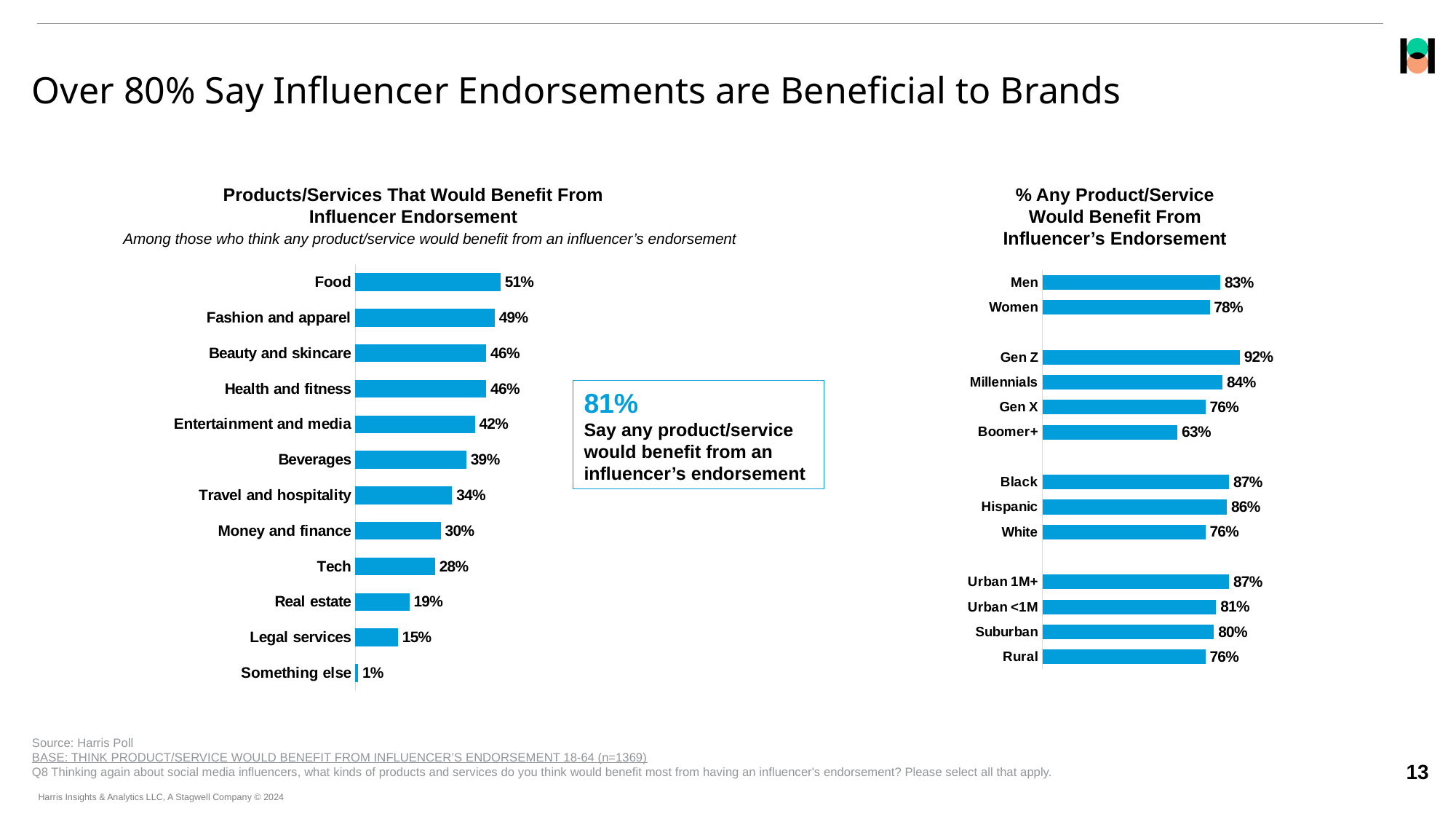
In the 'Products/Services That Would Benefit From Influencer Endorsement' chart, how many categories are shown? 12 In the '% Any Product/Service Would Benefit From Influencer's Endorsement' chart, which is larger: Hispanic or White? Hispanic In the 'Products/Services That Would Benefit From Influencer Endorsement' chart, which category has the lowest value? Something else In the 'Products/Services That Would Benefit From Influencer Endorsement' chart, what is the difference between Food and Legal services? 36% What type of chart is the '% Any Product/Service Would Benefit From Influencer's Endorsement' chart? Bar chart In the '% Any Product/Service Would Benefit From Influencer's Endorsement' chart, what is the value for Boomer+? 63% What percentage is highlighted in the text box between the two charts as saying any product/service would benefit from an influencer's endorsement? 81% In the '% Any Product/Service Would Benefit From Influencer's Endorsement' chart, what is the difference between Men and Women? 5% In the 'Products/Services That Would Benefit From Influencer Endorsement' chart, what is the value for Tech? 28% In the '% Any Product/Service Would Benefit From Influencer's Endorsement' chart, which category has the highest value? Gen Z In the 'Products/Services That Would Benefit From Influencer Endorsement' chart, what is the value for Food? 51% In the 'Products/Services That Would Benefit From Influencer Endorsement' chart, which is larger: Beverages or Travel and hospitality? Beverages